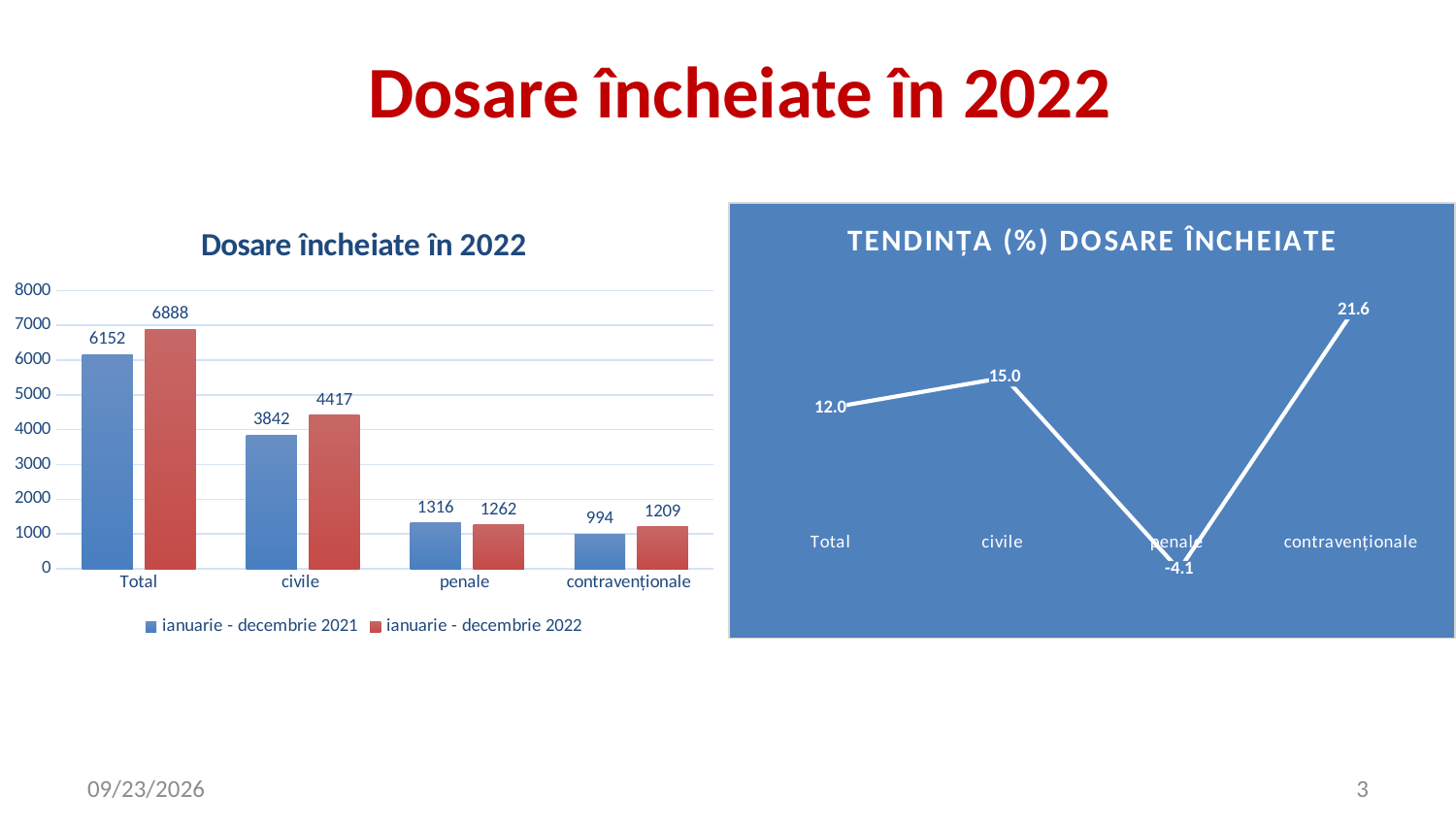
How many categories are shown on the x axis of the 'TENDINȚA (%) DOSARE ÎNCHEIATE' chart? 4 In the 'Dosare încheiate în 2022' bar chart, what is the value for civile in ianuarie - decembrie 2022? 4417 In the 'Dosare încheiate în 2022' bar chart, which is larger for penale: ianuarie - decembrie 2021 or ianuarie - decembrie 2022? ianuarie - decembrie 2021 In the 'TENDINȚA (%) DOSARE ÎNCHEIATE' chart, what is the value for contravenționale? 21.6 In the 'Dosare încheiate în 2022' bar chart, which category has the lowest value for ianuarie - decembrie 2021? contravenționale How many series does the legend of the 'Dosare încheiate în 2022' bar chart list? 2 In the 'TENDINȚA (%) DOSARE ÎNCHEIATE' chart, what is the difference between the values for civile and Total? 3.0 What kind of chart is 'TENDINȚA (%) DOSARE ÎNCHEIATE'? line chart In the 'TENDINȚA (%) DOSARE ÎNCHEIATE' chart, which category has the lowest value? penale What kind of chart is 'Dosare încheiate în 2022'? bar chart In the 'Dosare încheiate în 2022' bar chart, what is the value for penale in ianuarie - decembrie 2021? 1316 In the 'Dosare încheiate în 2022' bar chart, what is the difference between the Total values for ianuarie - decembrie 2022 and ianuarie - decembrie 2021? 736